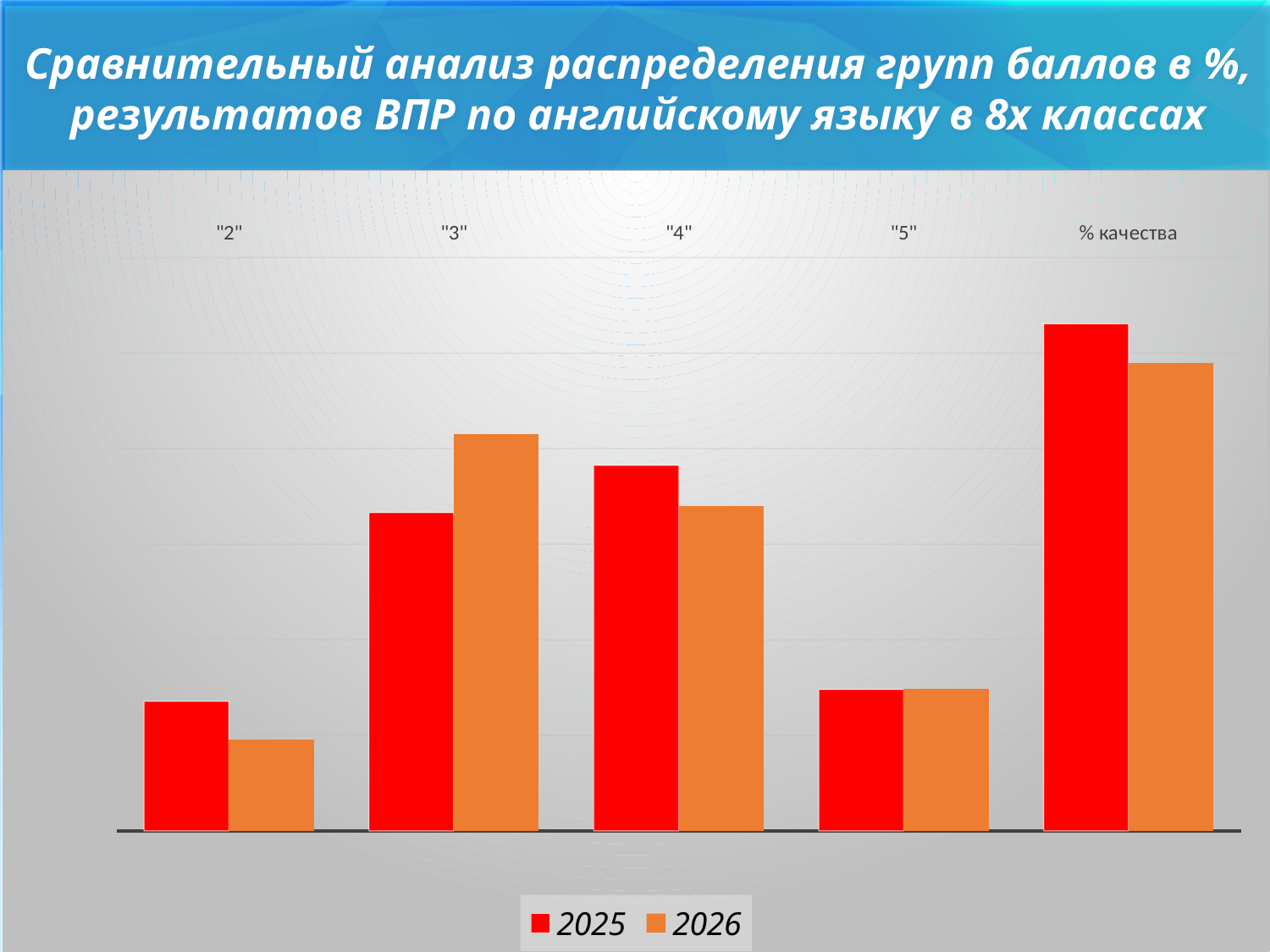
For the category "4", which series has the larger value, 2025 or 2026? 2025 Which category has the lowest value for the 2026 series? "2" Which series is shown in red in the chart's legend? 2025 For the category "2", which series has the larger value, 2025 or 2026? 2025 Which category has the highest value for the 2025 series? % качества What kind of chart is shown on the slide? bar chart How many categories are shown along the x axis of the chart? 5 For the category "3", which series has the larger value, 2025 or 2026? 2026 Which category has the lowest value for the 2025 series? "2" Which category has the highest value for the 2026 series? % качества How many series does the chart's legend list? 2